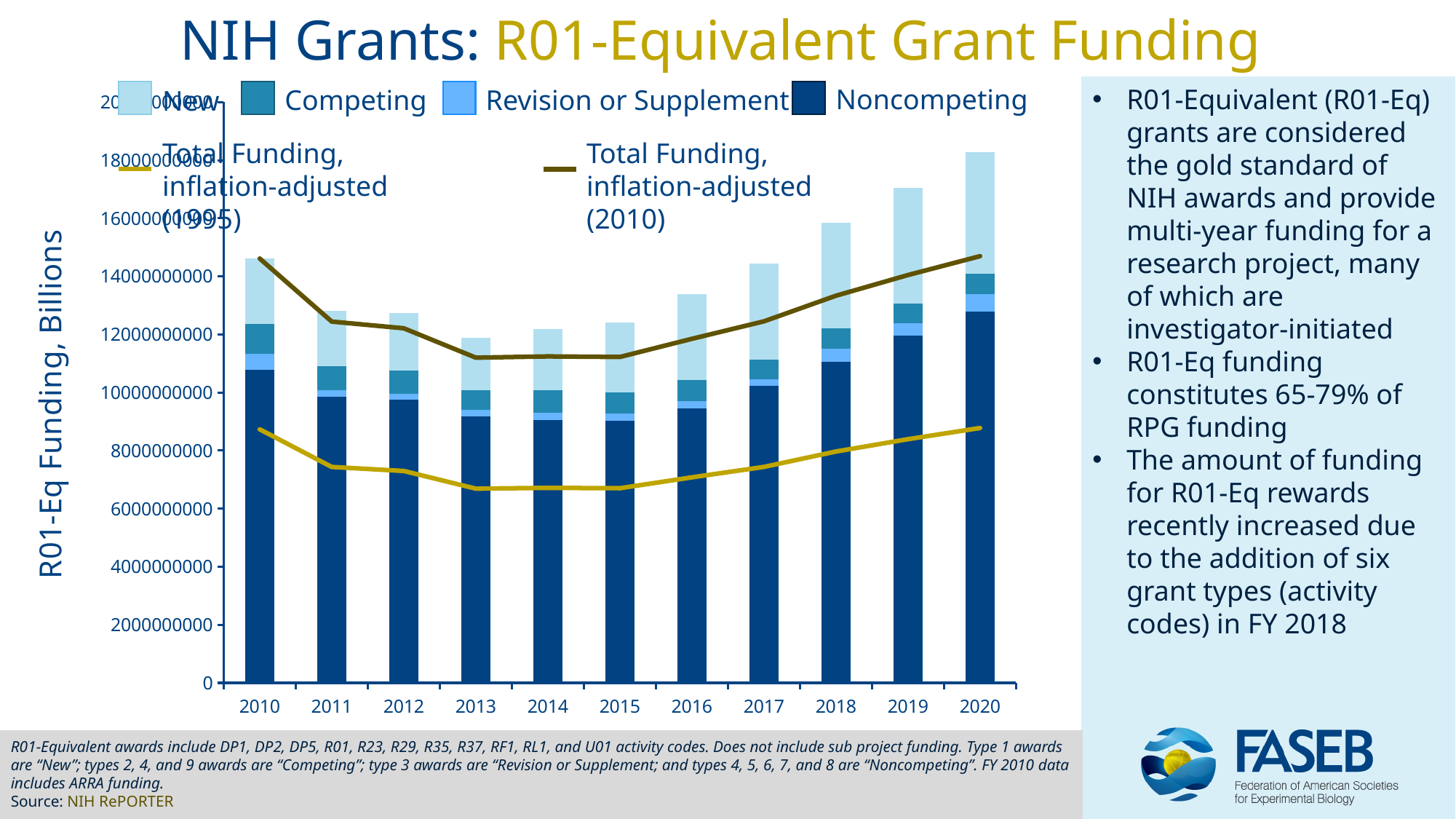
Do the stacked bar totals rise or fall from 2015 to 2020? rise What is the title of the chart's y axis? R01-Eq Funding, Billions Is the Noncompeting value for 2010 greater or less than 10000000000? greater Is the Total Funding, inflation-adjusted (1995) line value for 2020 greater or less than 10000000000? less Which year has the taller stacked bar, 2010 or 2020? 2020 What kind of chart is shown on the slide? bar and line chart Is the total stacked bar for 2010 greater or less than 14000000000? greater Which year has the tallest stacked bar? 2020 How many years are shown on the x axis of the chart? 11 How many series does the chart's legend list? 6